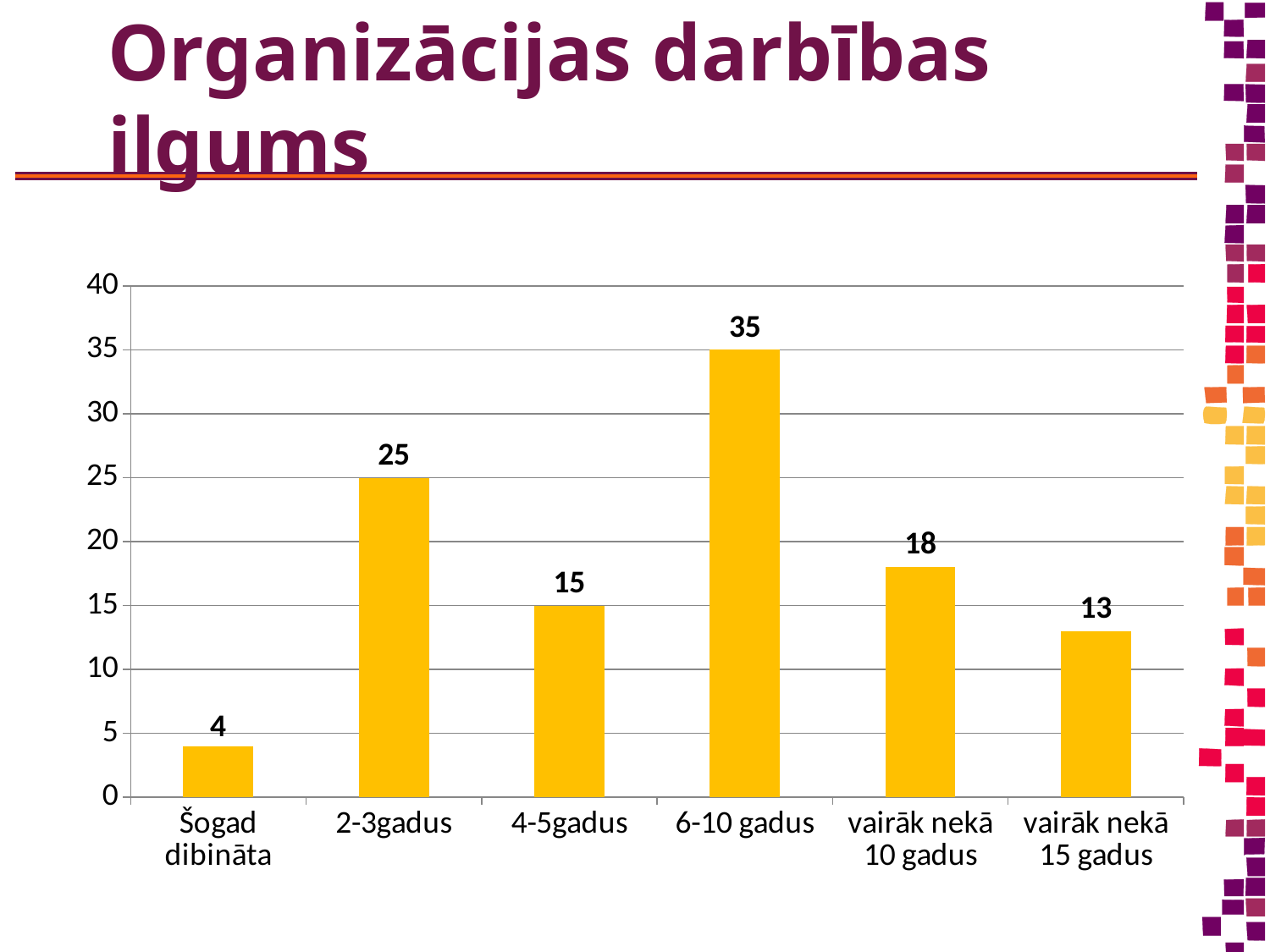
What is the title of the slide? Organizācijas darbības ilgums Which category has the lowest value? Šogad dibināta What is the difference between the values for '6-10 gadus' and '2-3gadus'? 10 Which is larger, the value for '2-3gadus' or the value for '4-5gadus'? 2-3gadus How many categories are shown on the x axis? 6 What is the value for 'vairāk nekā 15 gadus'? 13 What kind of chart is shown on the slide? bar chart What is the value for the '6-10 gadus' category? 35 Is the value for 'vairāk nekā 10 gadus' greater or less than 20? less What is the difference between the values for 'vairāk nekā 10 gadus' and 'vairāk nekā 15 gadus'? 5 Which category has the highest value? 6-10 gadus What is the value for the 'Šogad dibināta' category? 4